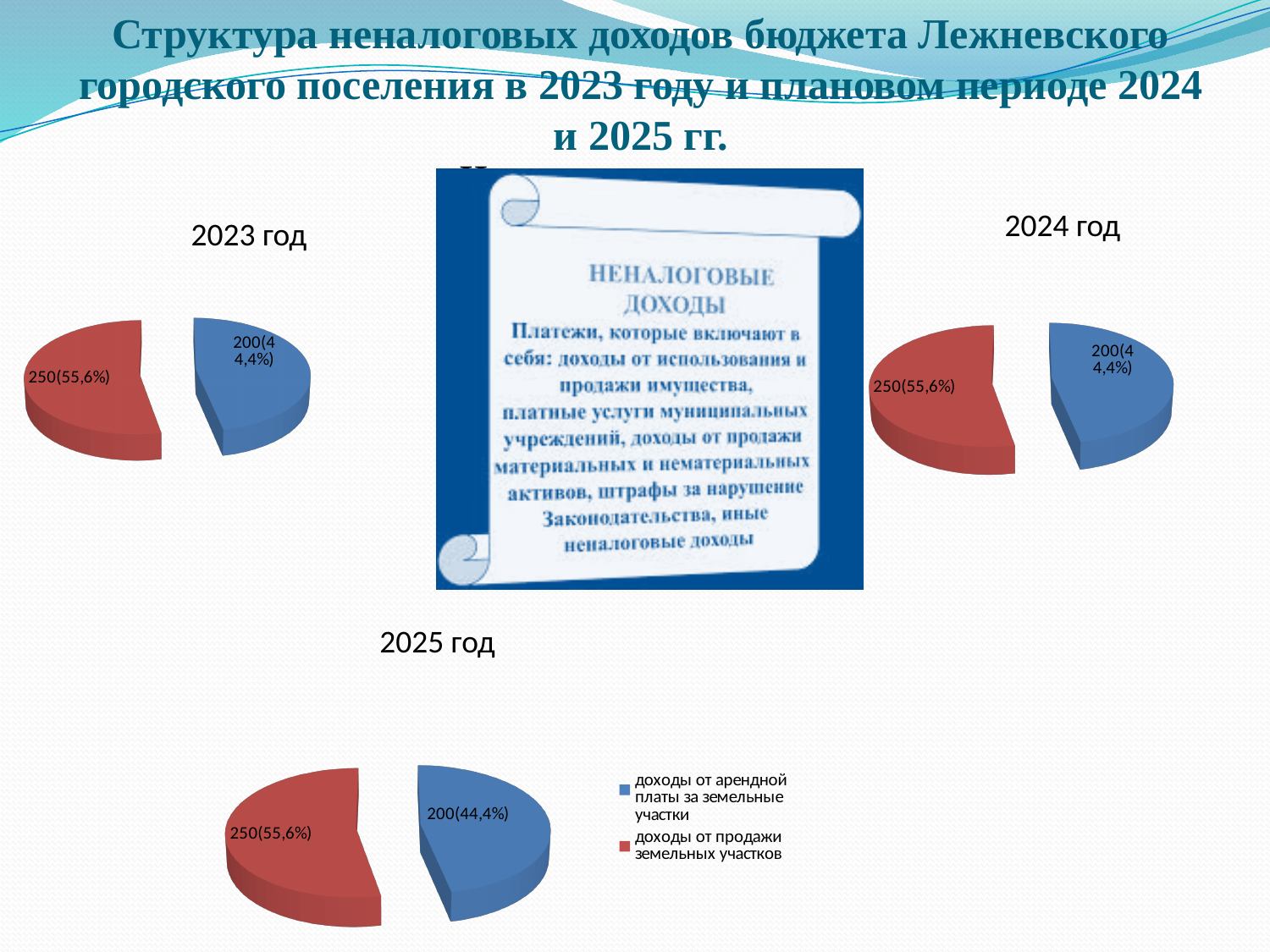
What type of chart is used for the 2023 год chart? pie chart In the 2025 год chart, what is the difference between the value for доходы от продажи земельных участков and the value for доходы от арендной платы за земельные участки? 50 In the 2025 год chart, what share of the pie does доходы от арендной платы за земельные участки take? 44,4% In the 2025 год chart, what value is shown for доходы от продажи земельных участков? 250(55,6%) In the 2025 год chart, what share of the pie does доходы от продажи земельных участков take? 55,6% How many slices does the 2024 год pie chart have? 2 In the 2025 год chart, which category has the smallest slice? доходы от арендной платы за земельные участки How many entries does the legend of the 2025 год chart list? 2 In the 2025 год chart, what colour is the slice for доходы от продажи земельных участков? red In the 2025 год chart, what value is shown for доходы от арендной платы за земельные участки? 200(44,4%) How many pie charts are shown on the slide? 3 In the 2025 год chart, which category has the largest slice? доходы от продажи земельных участков